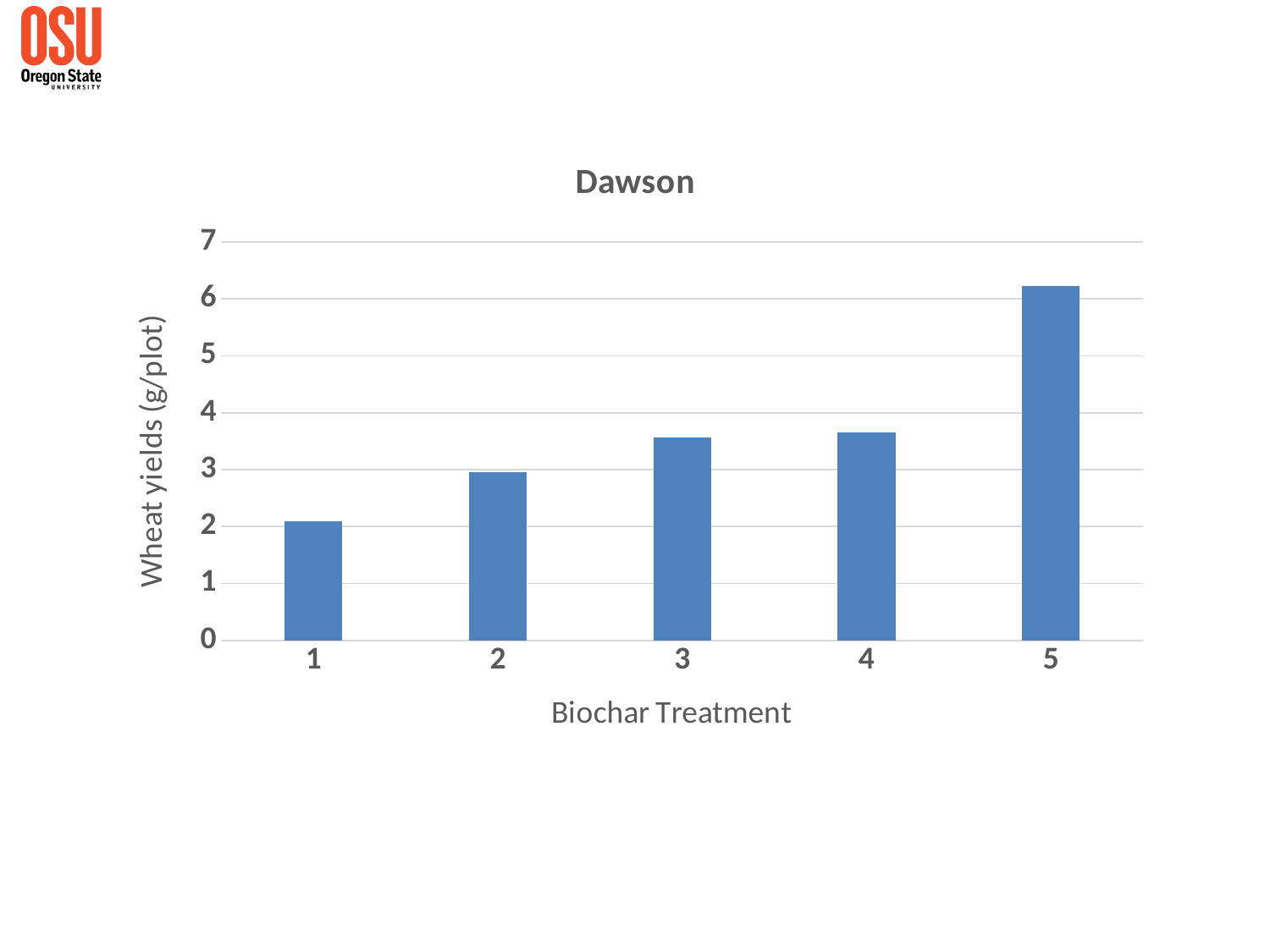
What is the title of the chart? Dawson Do wheat yields generally rise or fall from biochar treatment 1 to treatment 5? rise Is the wheat yield for biochar treatment 1 greater or less than 3? less What kind of chart is shown on the slide? bar chart Which has the larger wheat yield, biochar treatment 1 or biochar treatment 2? 2 Which biochar treatment has the lowest wheat yield? 1 Which biochar treatment has the highest wheat yield? 5 How many biochar treatments are plotted in the chart? 5 Is the wheat yield for biochar treatment 3 greater or less than 4? less Is the wheat yield for biochar treatment 2 greater or less than 2? greater What is the label on the vertical axis of the chart? Wheat yields (g/plot)